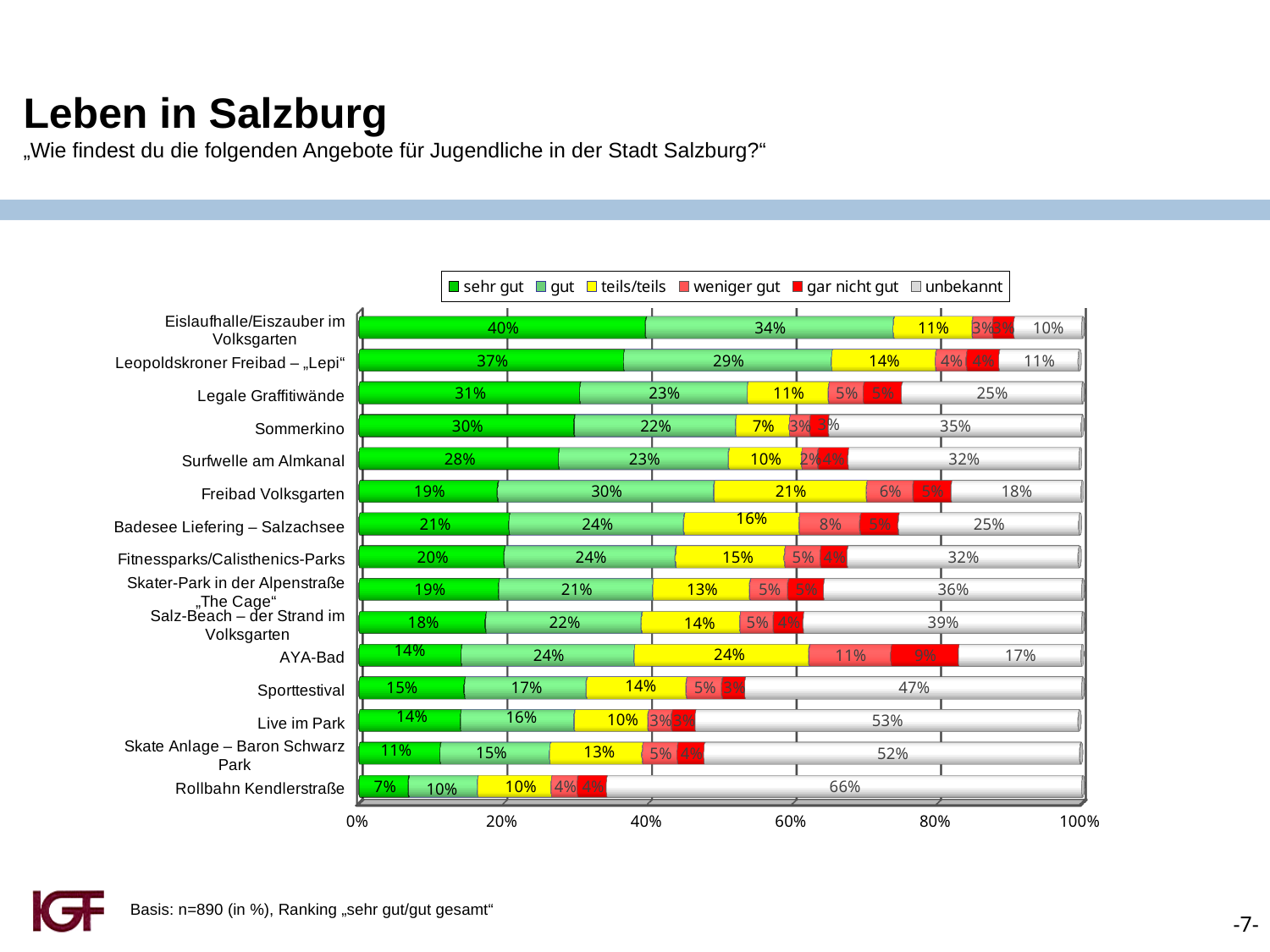
Which offering has the highest "unbekannt" share? Rollbahn Kendlerstraße How many series does the legend list? 6 What is the "weniger gut" value for AYA-Bad? 11% What is the "gut" value for Freibad Volksgarten? 30% Which offering has the lowest "sehr gut" share? Rollbahn Kendlerstraße Which offering has the highest "sehr gut" share? Eislaufhalle/Eiszauber im Volksgarten What is the difference between the "gut" values for Eislaufhalle/Eiszauber im Volksgarten and Leopoldskroner Freibad – „Lepi"? 5 percentage points How many offerings (categories) are shown in the chart? 15 Which has the larger "teils/teils" share: AYA-Bad or Freibad Volksgarten? AYA-Bad What percentage of respondents rated Eislaufhalle/Eiszauber im Volksgarten as "sehr gut"? 40% What kind of chart is shown on the slide? Stacked horizontal bar chart What is the "unbekannt" value for Rollbahn Kendlerstraße? 66%